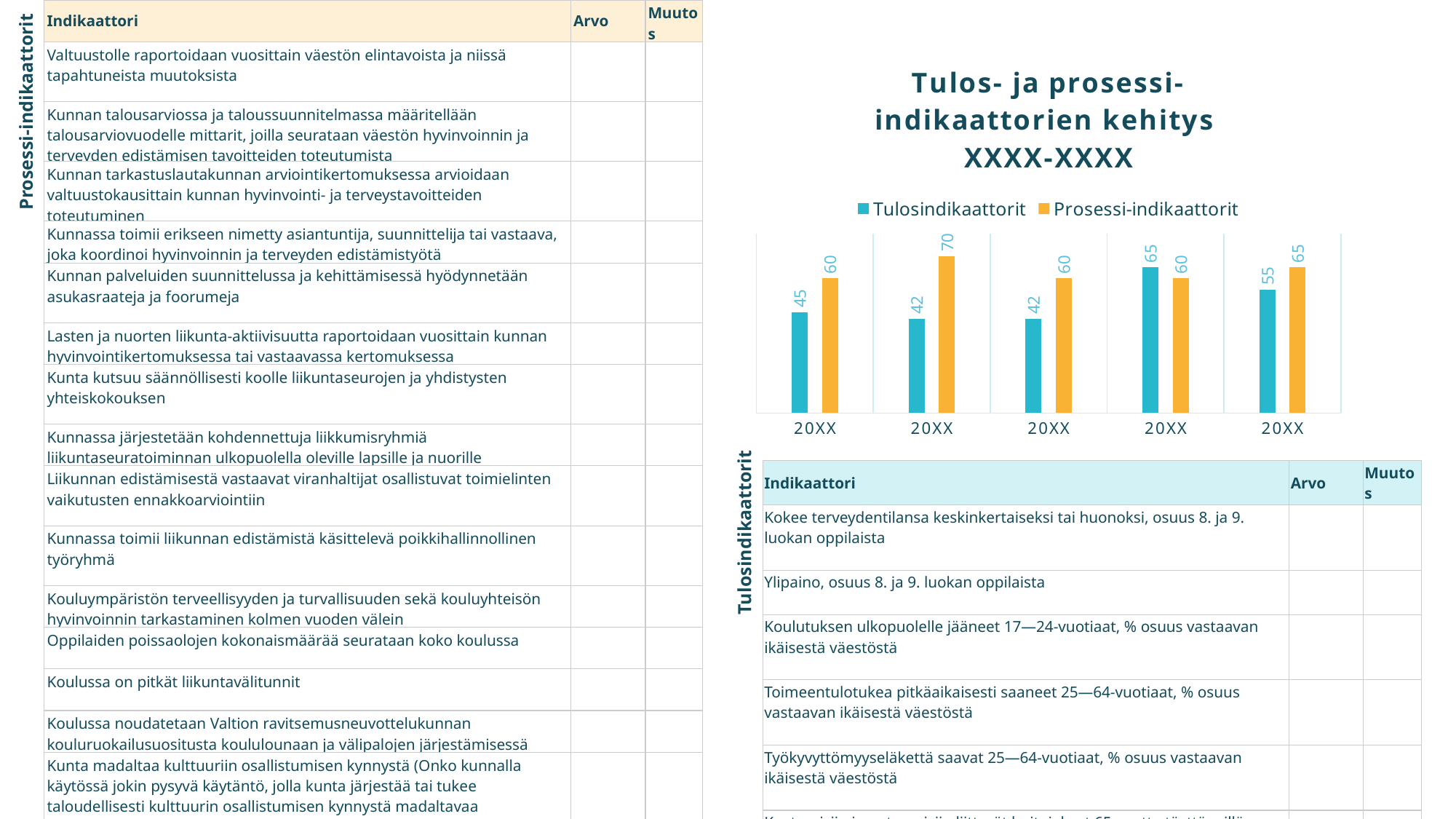
What is the value of Tulosindikaattorit for the fourth category from the left? 65 How many categories are shown along the x axis of the chart? 5 What is the lowest Tulosindikaattorit value shown in the chart? 42 What is the value of Prosessi-indikaattorit for the second category from the left? 70 How many series does the chart legend list? 2 What type of chart is shown on the slide? bar chart What is the difference between Prosessi-indikaattorit and Tulosindikaattorit in the first (leftmost) category? 15 What is the value of Prosessi-indikaattorit for the fifth (rightmost) category? 65 Which category has the highest Prosessi-indikaattorit value? the second category from the left (70) In the fourth category from the left, which series has the larger value, Tulosindikaattorit or Prosessi-indikaattorit? Tulosindikaattorit Which series is shown in orange in the chart? Prosessi-indikaattorit What is the value of Tulosindikaattorit for the first (leftmost) category? 45